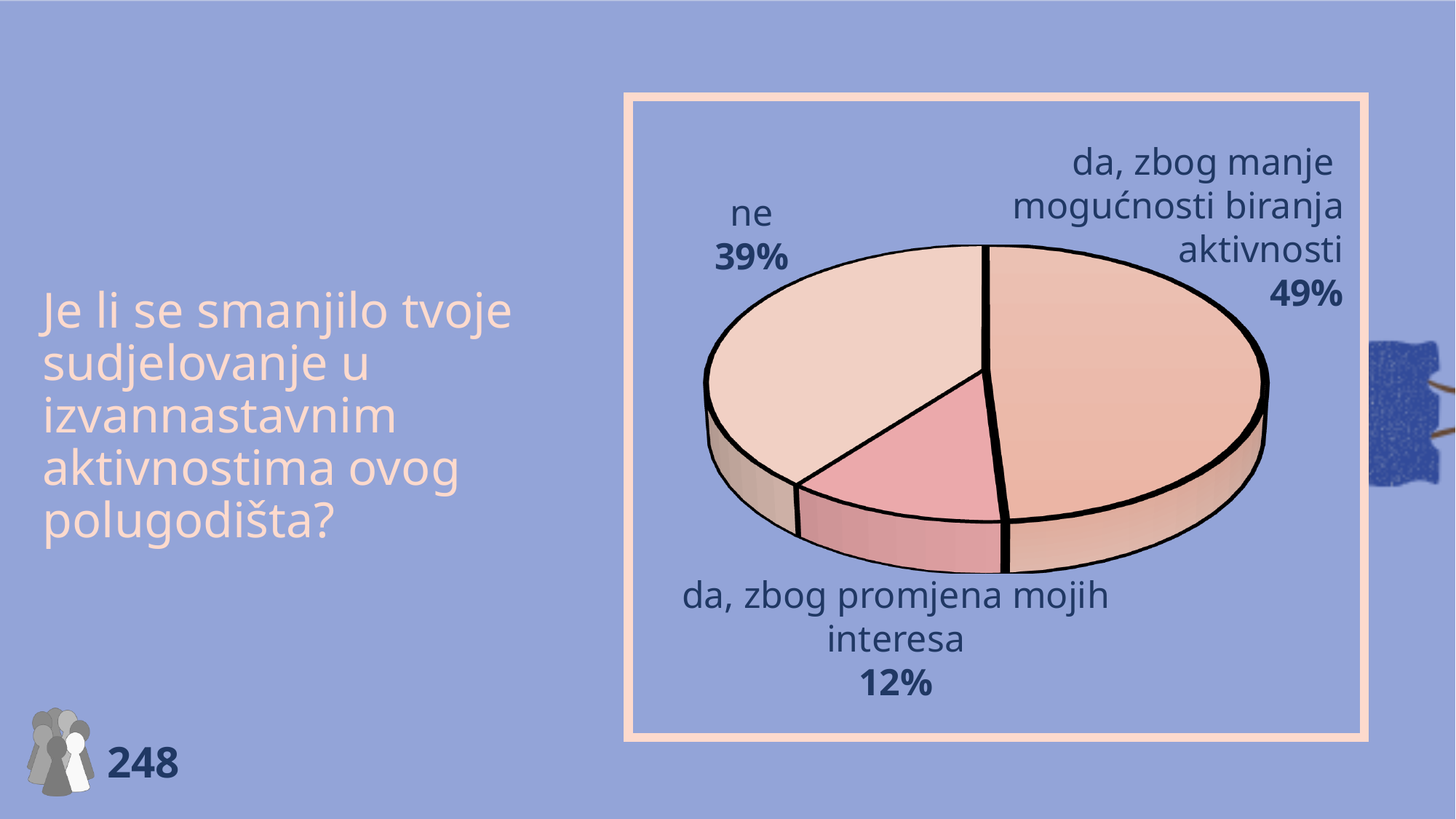
How many slices does the pie chart have? 3 What is the combined share of the two "da" slices? 61% Which slice of the pie is the largest? da, zbog manje mogućnosti biranja aktivnosti What share of the pie is labelled "ne"? 39% What is the difference in percentage points between the "ne" slice and the "da, zbog promjena mojih interesa" slice? 27 percentage points What share of the pie is labelled "da, zbog promjena mojih interesa"? 12% What kind of chart is shown on the slide? Pie chart What question is the chart on the slide answering? Je li se smanjilo tvoje sudjelovanje u izvannastavnim aktivnostima ovog polugodišta? Which is larger: the "ne" slice or the "da, zbog promjena mojih interesa" slice? ne What is the difference in percentage points between the "da, zbog manje mogućnosti biranja aktivnosti" slice and the "ne" slice? 10 percentage points Which slice of the pie is the smallest? da, zbog promjena mojih interesa What share of the pie is labelled "da, zbog manje mogućnosti biranja aktivnosti"? 49%